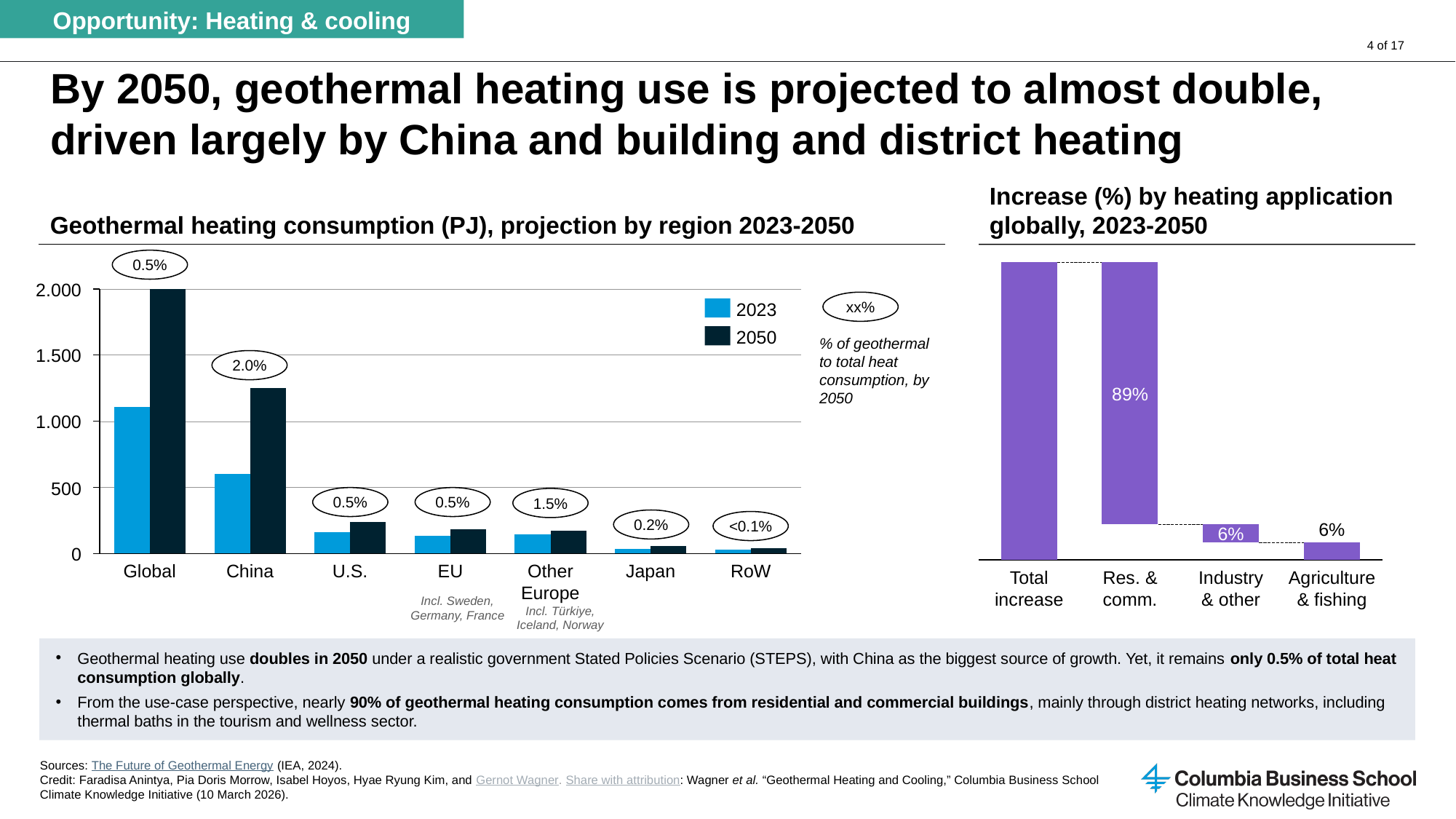
In the chart 'Geothermal heating consumption (PJ), projection by region 2023-2050', how many series does the legend list? 2 In the chart 'Geothermal heating consumption (PJ), projection by region 2023-2050', which is larger for China: the 2023 value or the 2050 value? 2050 In the chart 'Geothermal heating consumption (PJ), projection by region 2023-2050', which region has the highest 2050 value? Global In the chart 'Geothermal heating consumption (PJ), projection by region 2023-2050', what kind of chart is shown? bar chart In the chart 'Geothermal heating consumption (PJ), projection by region 2023-2050', which region has the lowest 2023 value? RoW In the chart 'Increase (%) by heating application globally, 2023-2050', what is the difference between the Res. & comm. value and the Industry & other value? 83% In the chart 'Geothermal heating consumption (PJ), projection by region 2023-2050', what is the share of geothermal to total heat consumption by 2050 shown for Other Europe? 1.5% In the chart 'Geothermal heating consumption (PJ), projection by region 2023-2050', what is the share of geothermal to total heat consumption by 2050 shown for China? 2.0% In the chart 'Geothermal heating consumption (PJ), projection by region 2023-2050', how many regions are shown on the x axis? 7 In the chart 'Increase (%) by heating application globally, 2023-2050', what is the value for Res. & comm.? 89% In the chart 'Geothermal heating consumption (PJ), projection by region 2023-2050', is the 2050 value for China greater or less than 1.500? less In the chart 'Geothermal heating consumption (PJ), projection by region 2023-2050', is the 2023 value for Global greater or less than 1.000? greater